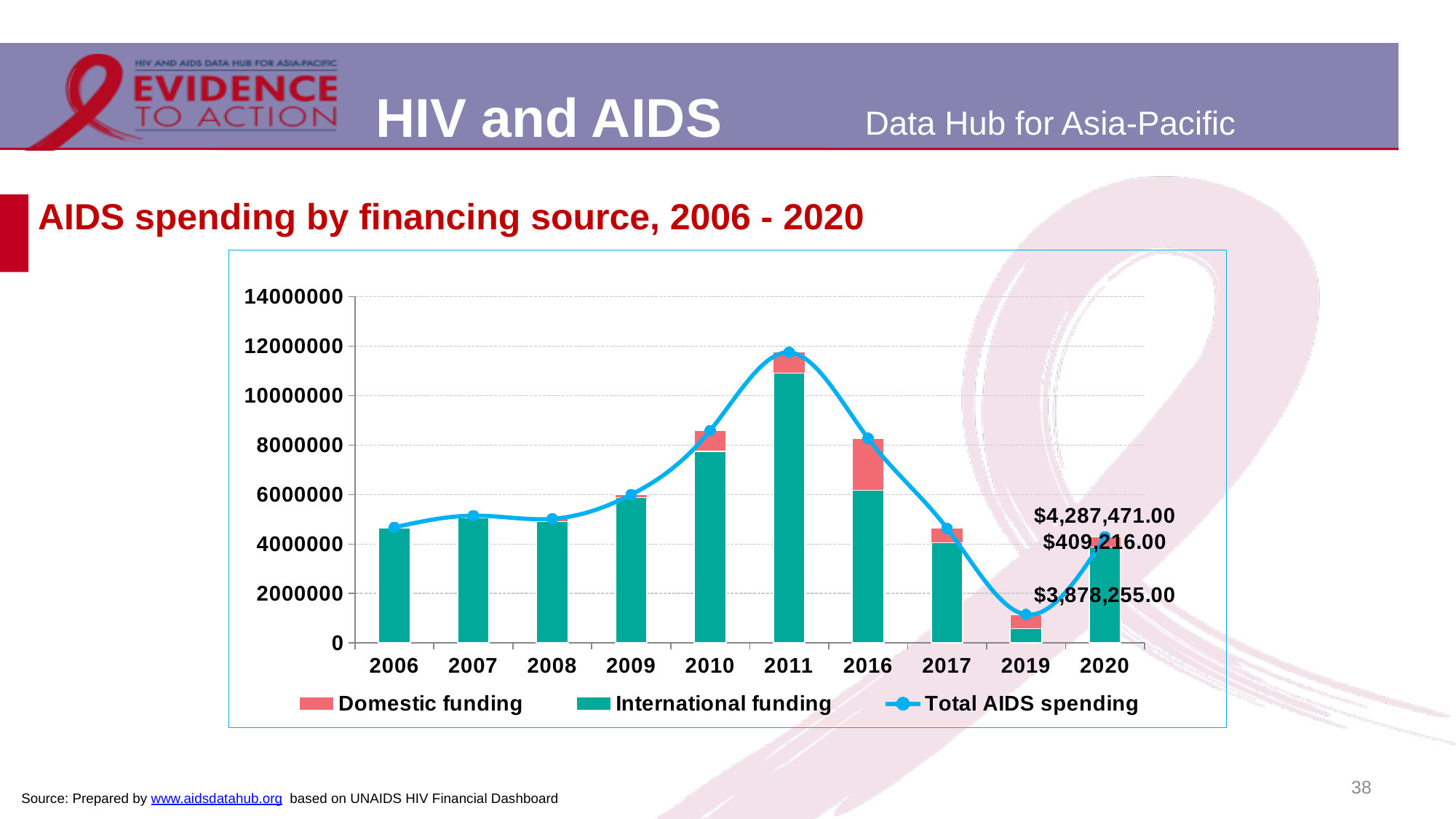
In which year is Total AIDS spending highest? 2011 Is Total AIDS spending in 2011 greater or less than 10000000? greater What is the Total AIDS spending value labelled for 2020? $4,287,471.00 What kind of chart is this? Stacked bar chart with a line Which colour represents Domestic funding in the legend? Red/pink Is International funding in 2010 greater or less than 6000000? greater How many years are shown on the x axis? 10 Does Total AIDS spending rise or fall from 2011 to 2019? fall How many series does the legend list? 3 In which year is Total AIDS spending lowest? 2019 Which year has higher Total AIDS spending, 2016 or 2017? 2016 Is Total AIDS spending in 2019 greater or less than 2000000? less